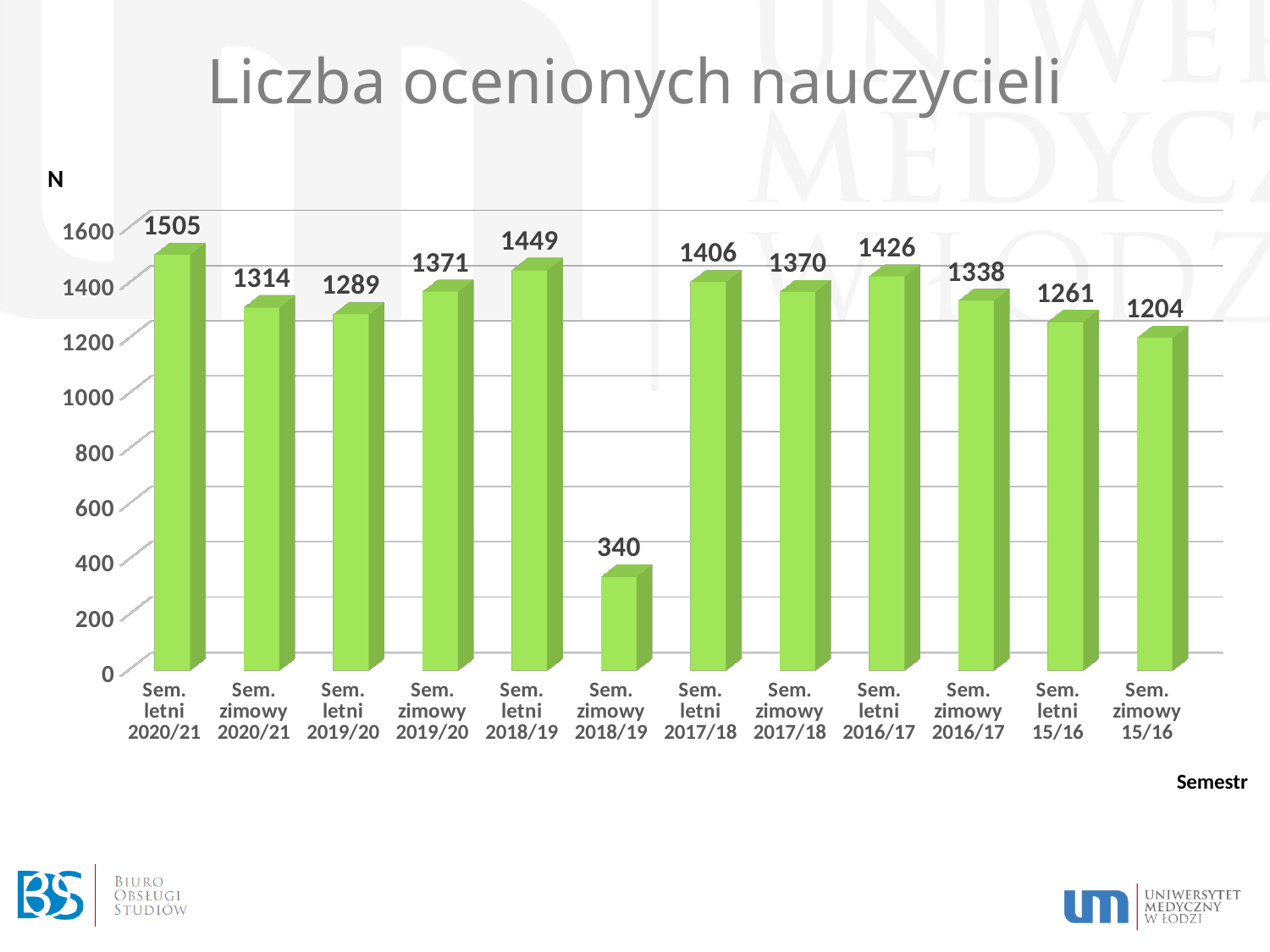
What is the value for Sem. letni 2020/21? 1505 Which semester has the highest number of evaluated teachers? Sem. letni 2020/21 What is the title of the chart? Liczba ocenionych nauczycieli What kind of chart is shown on the slide? bar chart Which semester has the lowest number of evaluated teachers? Sem. zimowy 2018/19 What is the difference between the values for Sem. letni 2020/21 and Sem. zimowy 2020/21? 191 Which is larger, the value for Sem. letni 2016/17 or Sem. zimowy 2016/17? Sem. letni 2016/17 What is the difference between the values for Sem. letni 2018/19 and Sem. zimowy 2018/19? 1109 What is the value for Sem. zimowy 15/16? 1204 How many semesters are shown on the x axis? 12 What label is shown on the x axis? Semestr What is the value for Sem. zimowy 2018/19? 340